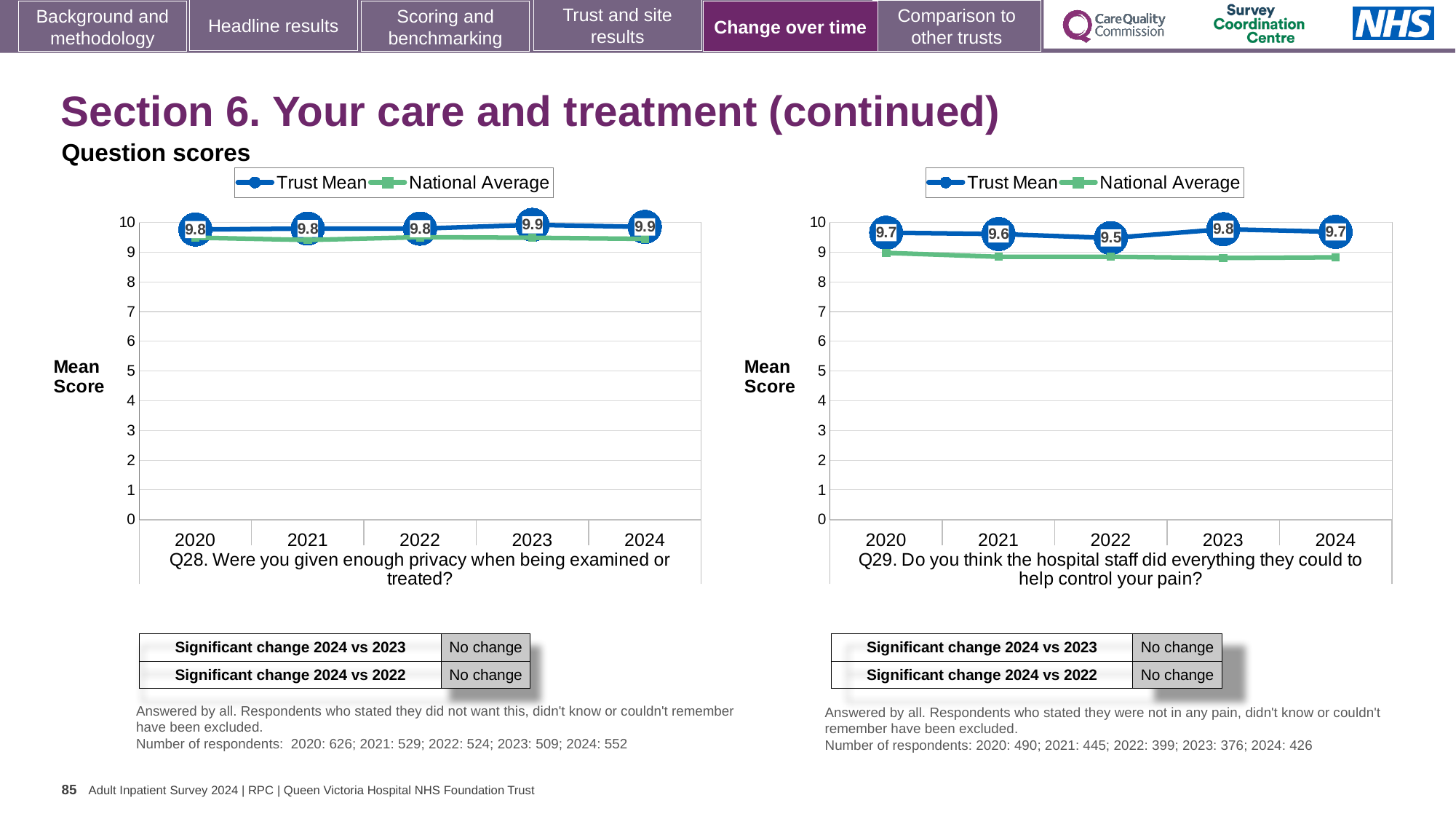
In the Q29 chart, what is the Trust Mean score for 2022? 9.5 In the Q29 chart, what is the difference between the Trust Mean scores for 2023 and 2022? 0.3 How many years are shown on the x axis of the Q28 chart? 5 In the Q28 chart, what is the Trust Mean score for 2024? 9.9 How many series does the legend of the Q29 chart list? 2 In the Q29 chart, does the Trust Mean rise or fall from 2020 to 2022? fall In the Q29 chart, which year has the highest Trust Mean score? 2023 In the Q28 chart, is the National Average value for 2022 greater or less than 9? greater What type of chart is used for Q28? Line chart What are the two series named in the legend of the Q28 chart? Trust Mean and National Average In the Q29 chart, which year has the lowest Trust Mean score? 2022 In the Q28 chart, is the Trust Mean score for 2023 larger or smaller than the score for 2020? larger